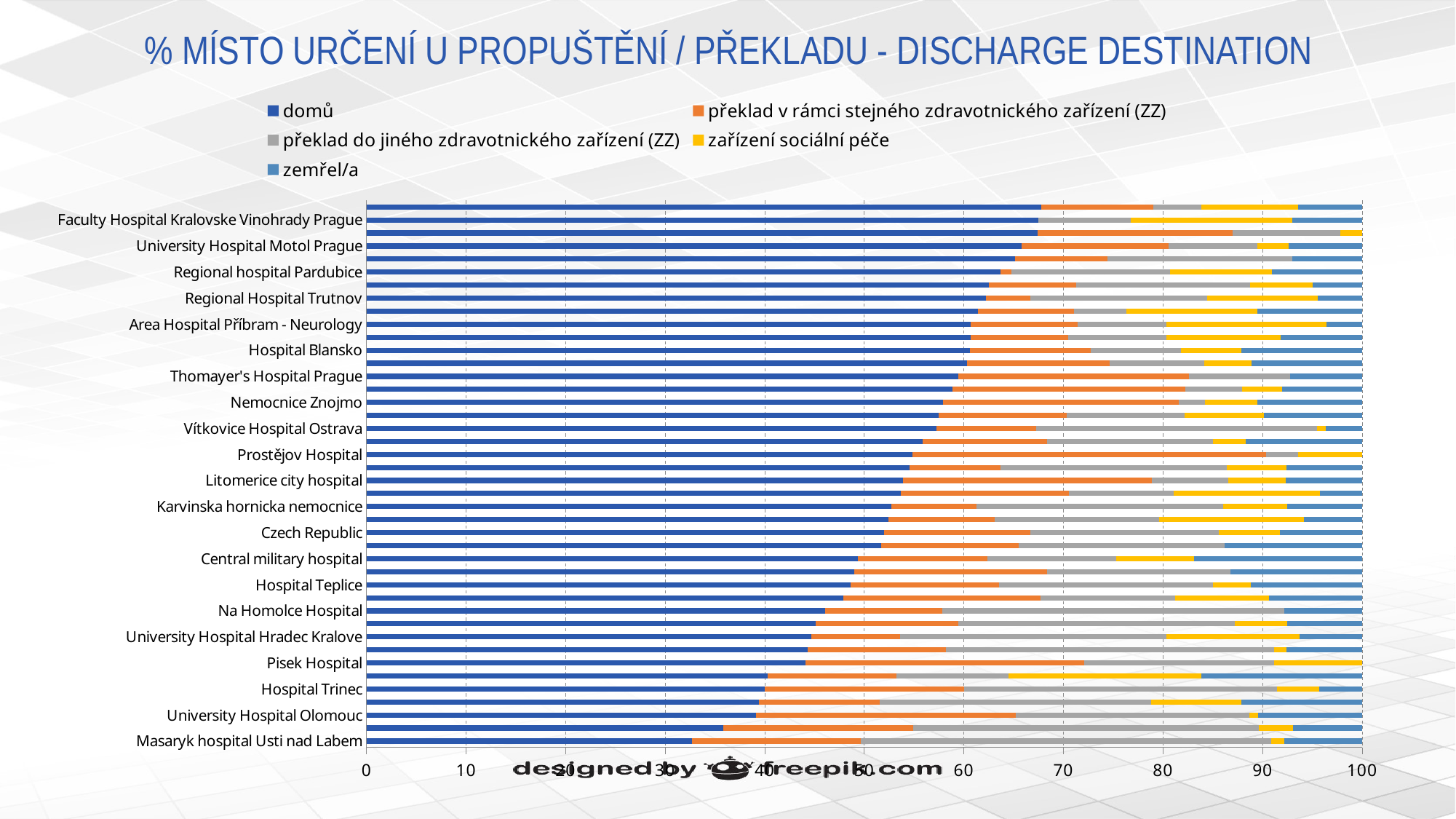
What kind of chart is shown on the slide? Stacked bar chart How many series does the legend list? 5 Which has a larger 'domů' share: Faculty Hospital Kralovske Vinohrady Prague or Masaryk hospital Usti nad Labem? Faculty Hospital Kralovske Vinohrady Prague What is the title of the chart? % MÍSTO URČENÍ U PROPUŠTĚNÍ / PŘEKLADU - DISCHARGE DESTINATION What is the maximum value shown on the horizontal axis? 100 Is the 'domů' value for Regional Hospital Trutnov greater or less than 50? greater Which legend entry is shown in yellow? zařízení sociální péče Which has a larger 'domů' share: University Hospital Olomouc or Hospital Blansko? Hospital Blansko Is the 'domů' value for Hospital Trinec greater or less than 50? less Is the 'domů' value for Masaryk hospital Usti nad Labem greater or less than 40? less